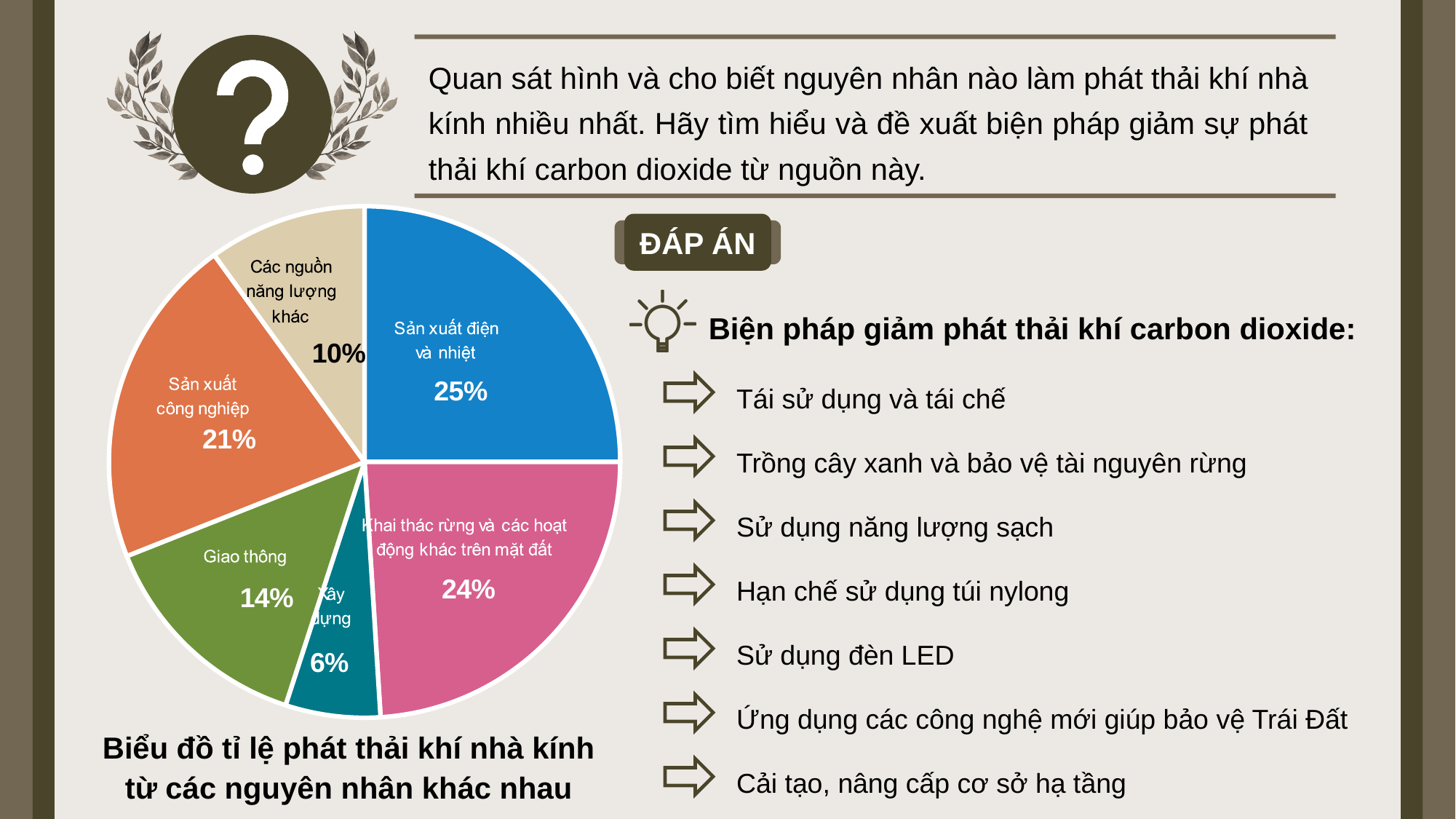
What is the difference between the shares of "Sản xuất công nghiệp" and "Các nguồn năng lượng khác"? 11% How many slices does the pie chart have? 6 What percentage is shown for "Sản xuất công nghiệp"? 21% Which is larger: the share for "Khai thác rừng và các hoạt động khác trên mặt đất" or the share for "Giao thông"? Khai thác rừng và các hoạt động khác trên mặt đất What is the value shown for "Xây dựng"? 6% What is the title written below the pie chart? Biểu đồ tỉ lệ phát thải khí nhà kính từ các nguyên nhân khác nhau Which category has the largest slice of the pie chart? Sản xuất điện và nhiệt What kind of chart is shown on the slide? pie chart What share does "Giao thông" have in the pie chart? 14% Which category has the smallest slice of the pie chart? Xây dựng What is the combined share of "Giao thông" and "Xây dựng"? 20% What percentage of greenhouse gas emissions does the chart attribute to "Sản xuất điện và nhiệt"? 25%